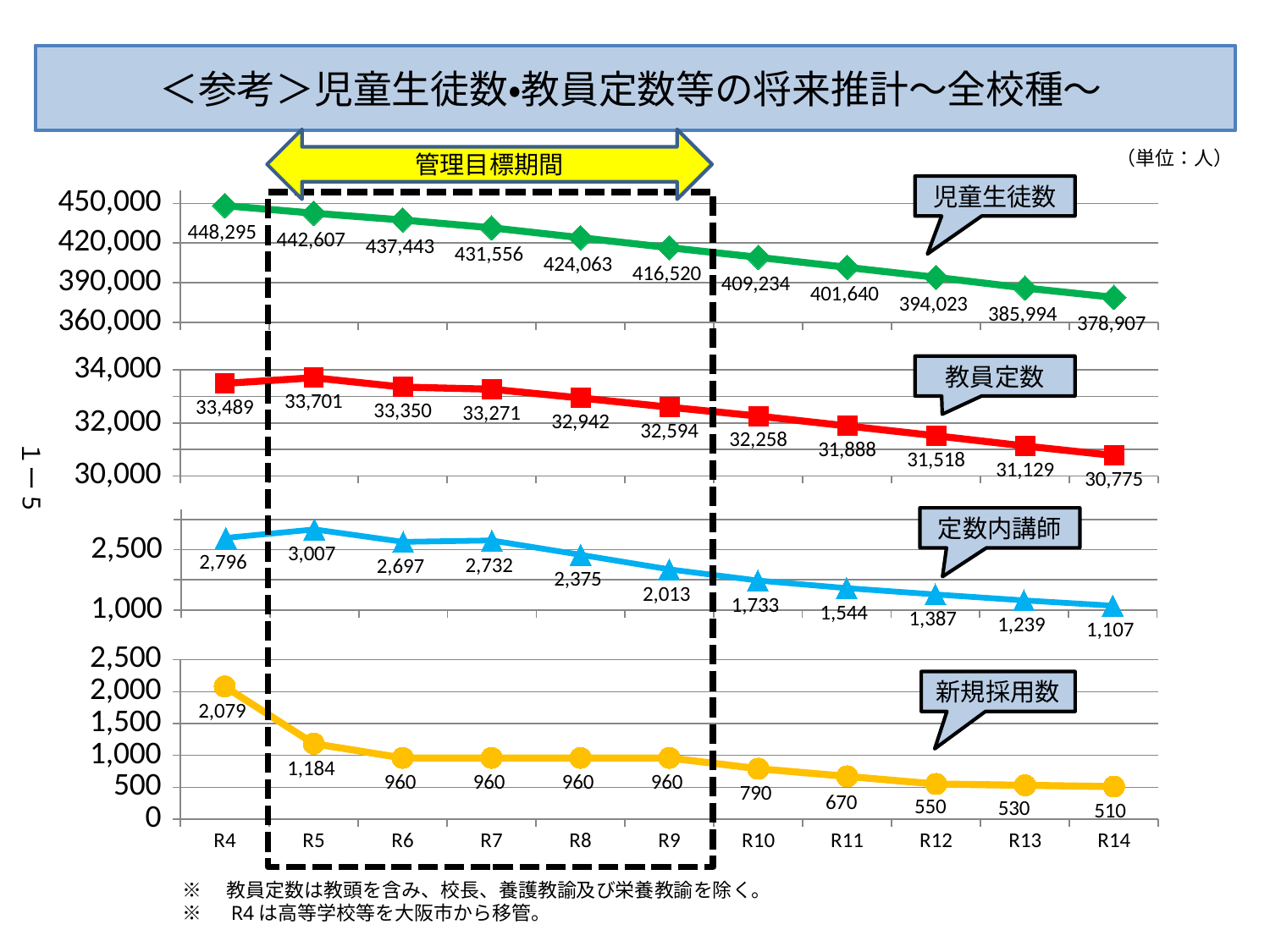
How many data series are plotted on the chart? 4 What is the value of 教員定数 (red line) for R12? 31,518 What kind of chart is shown on the slide? Line chart By how much does 児童生徒数 decrease from R4 to R14? 69,388 How many years are shown on the x axis? 11 What is the value of 定数内講師 (blue line) for R5? 3,007 What is the value of 児童生徒数 (green line) for R9? 416,520 What is the difference between 定数内講師 in R5 and in R9? 994 In which year is 教員定数 (red line) highest? R5 Which year has the larger 新規採用数, R10 or R11? R10 In which year is 新規採用数 (yellow line) lowest? R14 What is the value of 新規採用数 (yellow line) for R4? 2,079